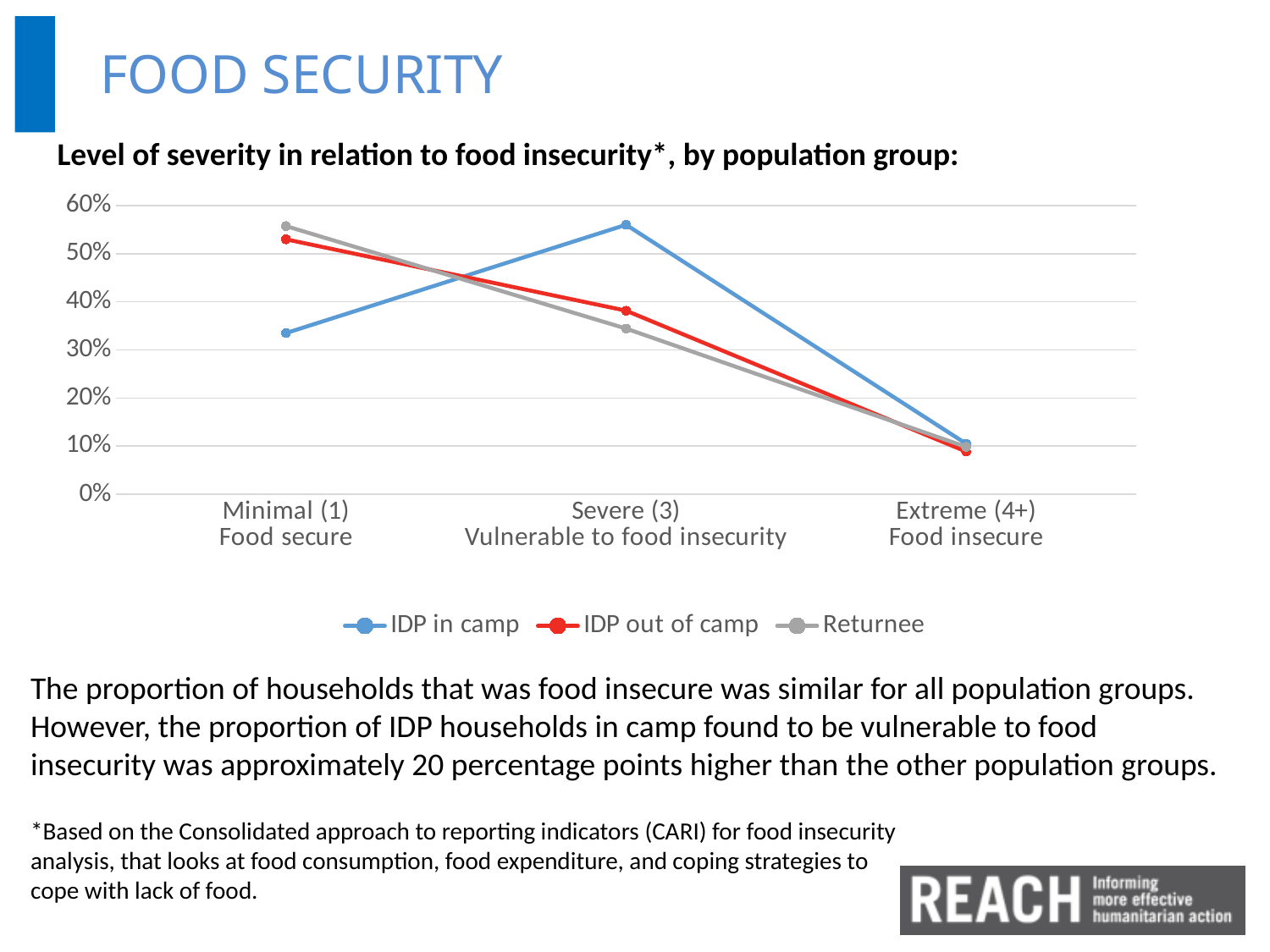
Which population group has the lowest value for Minimal (1) Food secure? IDP in camp Is the value for IDP in camp at Severe (3) Vulnerable to food insecurity greater or less than 50%? greater Do the values for IDP out of camp rise or fall from Minimal (1) to Extreme (4+)? fall How many series does the legend list? 3 Is the value for IDP in camp at Minimal (1) Food secure greater or less than 40%? less What kind of chart is shown on the slide? line chart Is the value for IDP out of camp at Minimal (1) Food secure greater or less than 50%? greater For Minimal (1) Food secure, which is larger: the value for Returnee or the value for IDP in camp? Returnee Which population group has the highest value for Severe (3) Vulnerable to food insecurity? IDP in camp Which colour is used for the Returnee series? grey How many categories are shown on the x axis? 3